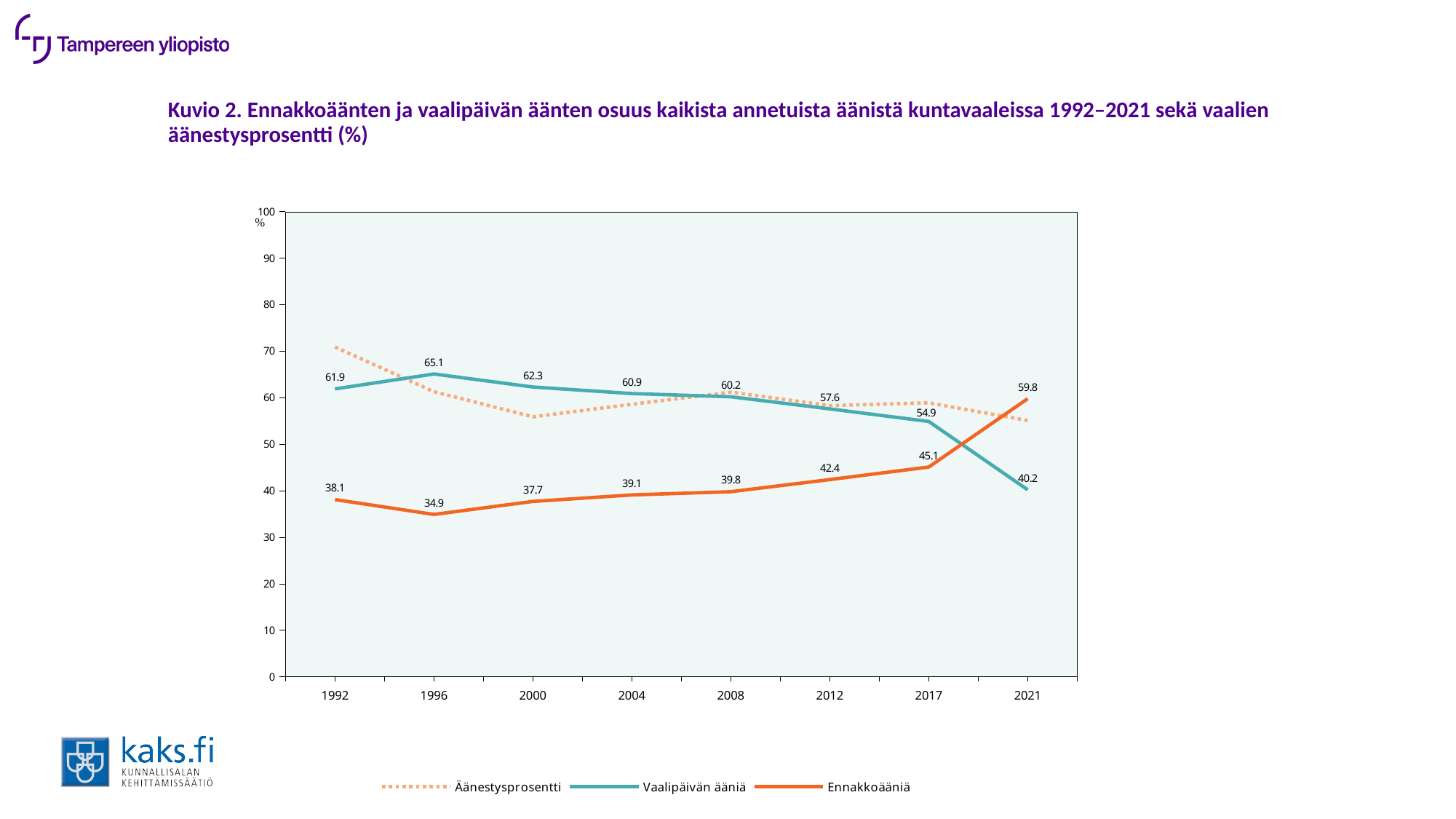
What is the value for Vaalipäivän ääniä in 1996? 65.1 Does Vaalipäivän ääniä rise or fall from 1996 to 2021? fall Which series is drawn with a dotted line? Äänestysprosentti What kind of chart is shown on the slide? line chart Is the value for Äänestysprosentti in 1992 greater or less than 60? greater How many series does the legend list? 3 In which year is Vaalipäivän ääniä at its highest? 1996 In 2021, which is larger: Ennakkoääniä or Vaalipäivän ääniä? Ennakkoääniä How many election years are shown on the x axis? 8 In which year is Ennakkoääniä at its lowest? 1996 What is the value for Ennakkoääniä in 2021? 59.8 By how much did Ennakkoääniä increase from 2017 to 2021? 14.7